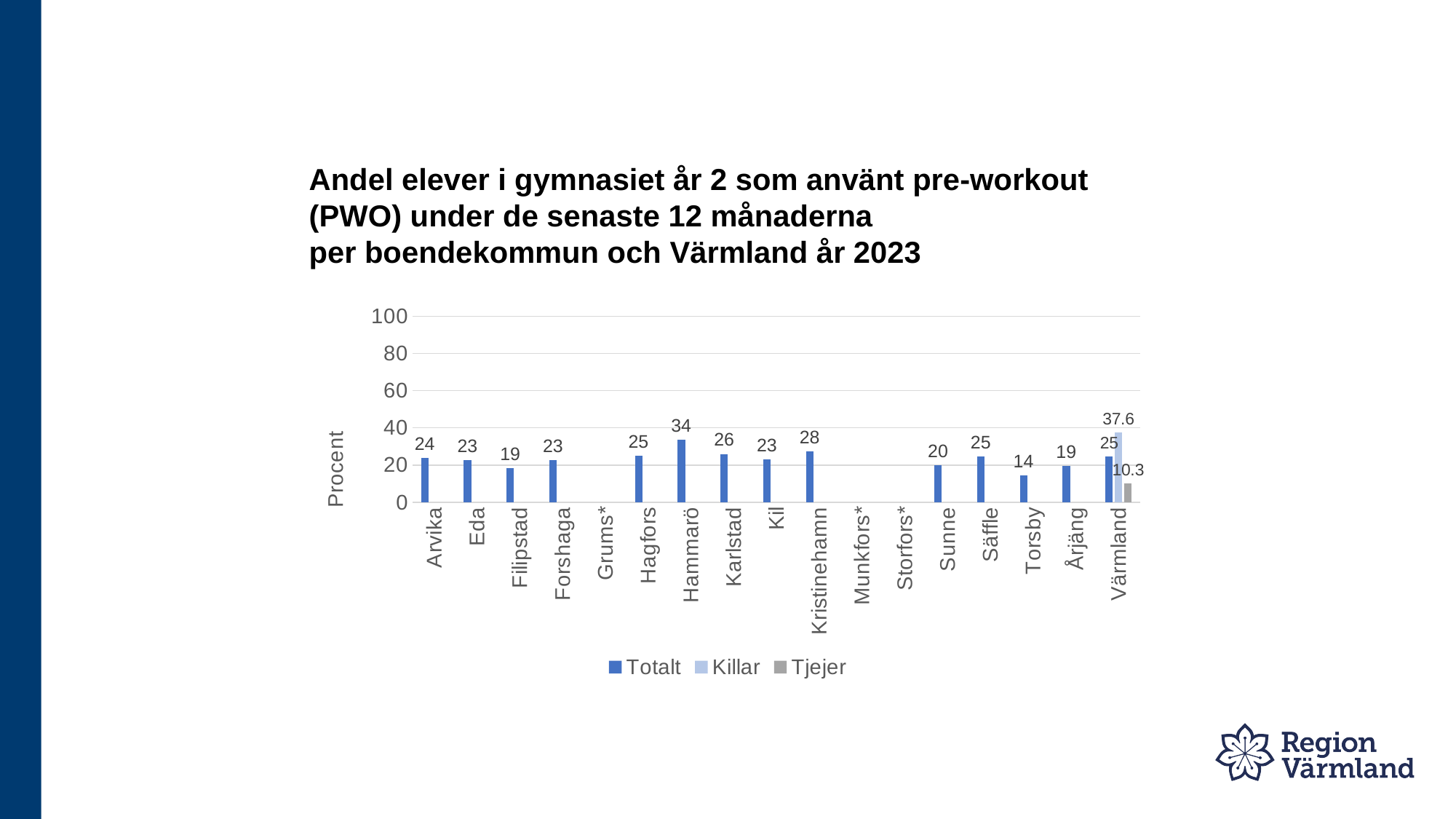
How many categories are shown on the x axis? 17 What is the Tjejer value for Värmland? 10.3 Which is larger, the Totalt value for Karlstad or for Kristinehamn? Kristinehamn What is the difference between the Totalt values for Hammarö and Torsby? 20 How many series does the legend list? 3 Which municipality with a plotted bar has the lowest Totalt value? Torsby What is the Totalt value for Torsby? 14 Which municipality has the highest Totalt value? Hammarö What is the Killar value for Värmland? 37.6 What kind of chart is shown on the slide? Bar chart What is the Totalt value for Hammarö? 34 What is the label of the y axis? Procent